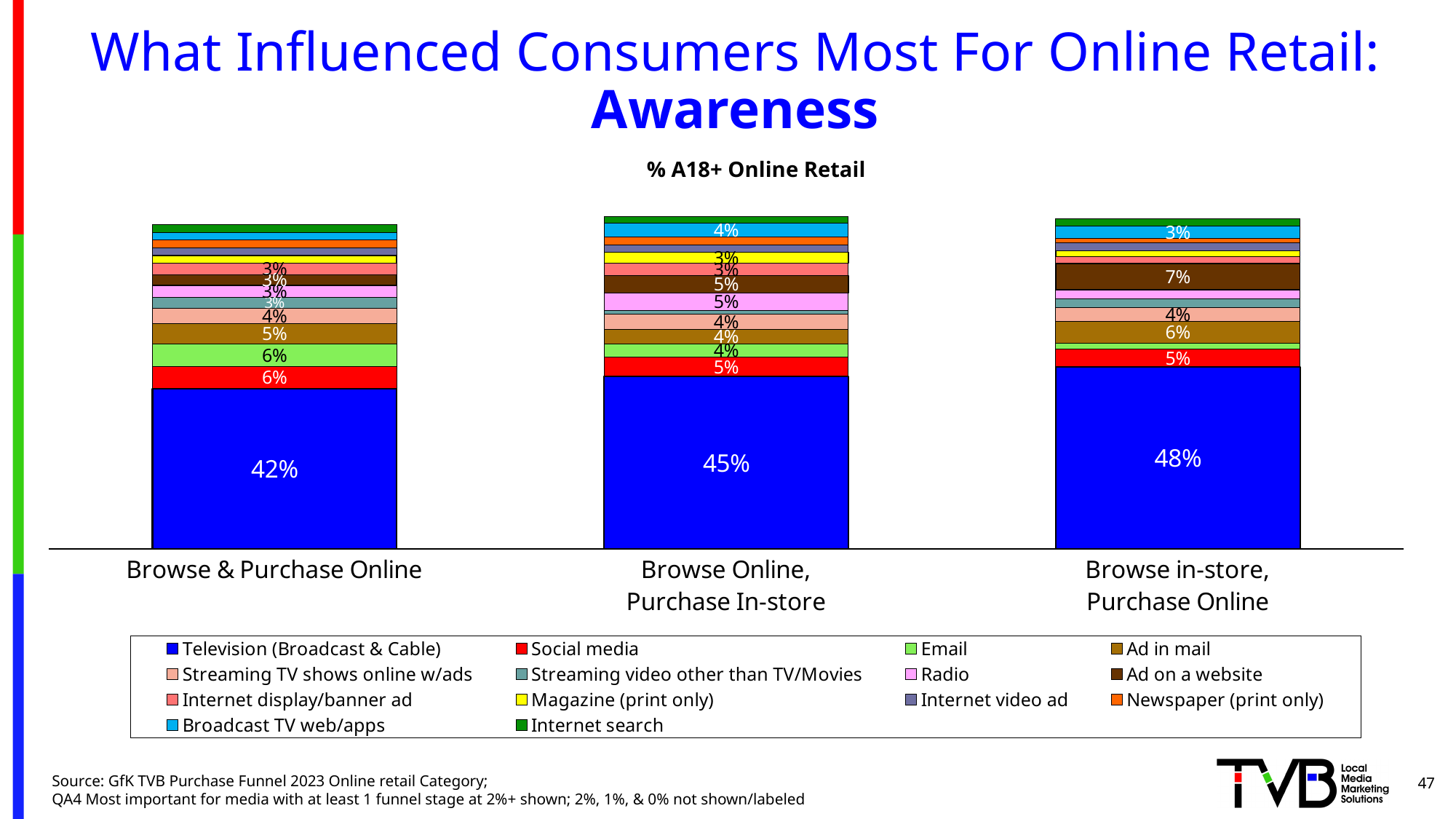
Do the Television (Broadcast & Cable) values rise or fall from left to right across the three bars? Rise What is the difference between the Television (Broadcast & Cable) values for Browse in-store, Purchase Online and Browse & Purchase Online? 6 percentage points How many series does the legend list? 14 Which category has the highest Television (Broadcast & Cable) value? Browse in-store, Purchase Online What is the value for Ad on a website in the Browse in-store, Purchase Online bar? 7% Which category has the larger Ad in mail value: Browse & Purchase Online or Browse in-store, Purchase Online? Browse in-store, Purchase Online What is the value for Television (Broadcast & Cable) in the Browse in-store, Purchase Online bar? 48% What is the value for Television (Broadcast & Cable) in the Browse & Purchase Online bar? 42% What kind of chart is shown on the slide? Stacked bar chart What is the value for Broadcast TV web/apps in the Browse Online, Purchase In-store bar? 4% How many categories (bars) are shown on the x axis? 3 What is the value for Social media in the Browse & Purchase Online bar? 6%